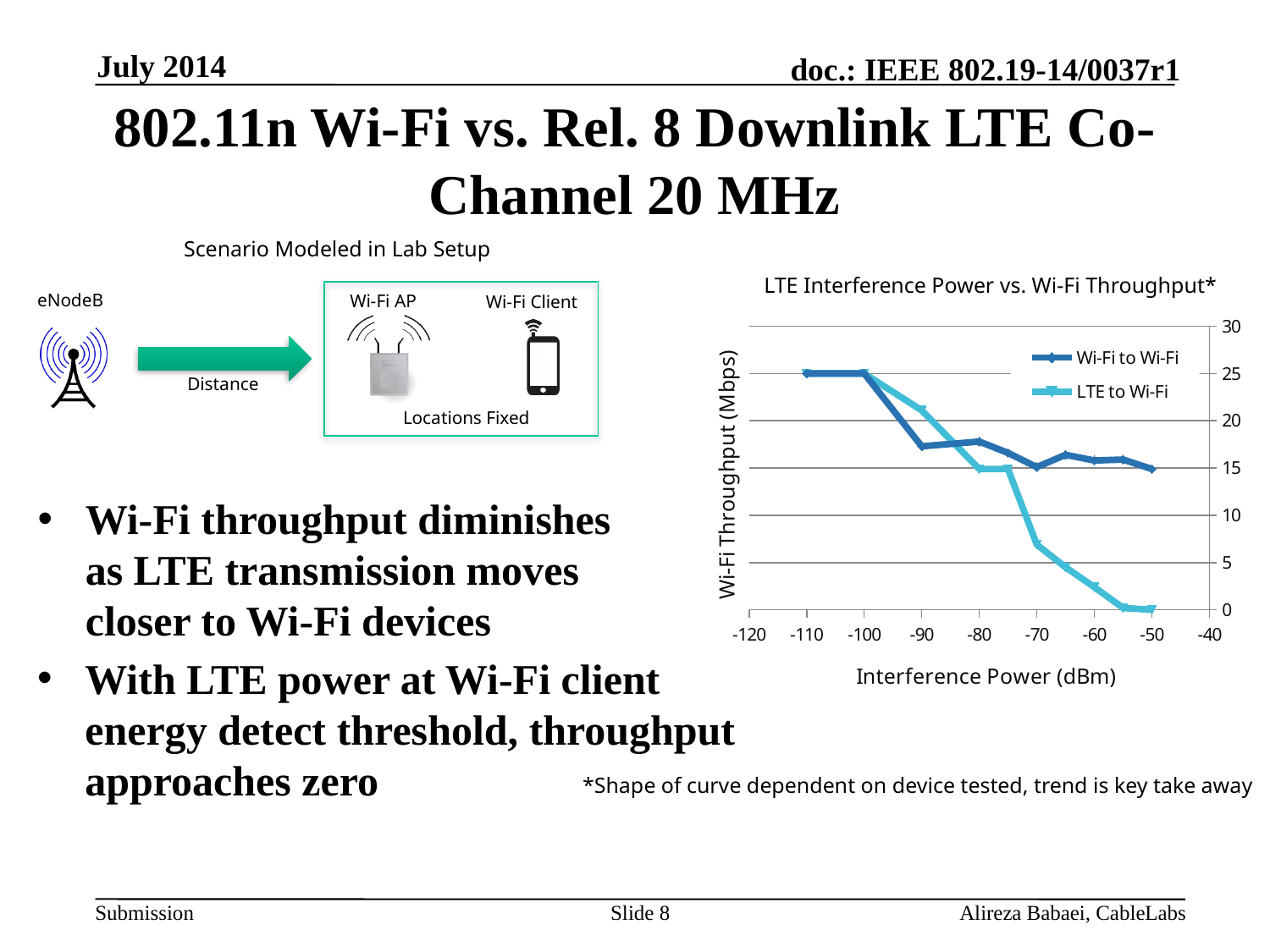
At -60 dBm interference power, which series has the lower Wi-Fi throughput, Wi-Fi to Wi-Fi or LTE to Wi-Fi? LTE to Wi-Fi At -70 dBm interference power, which series has the higher Wi-Fi throughput, Wi-Fi to Wi-Fi or LTE to Wi-Fi? Wi-Fi to Wi-Fi How many series does the chart legend list? 2 Is the Wi-Fi to Wi-Fi throughput at -50 dBm interference power greater or less than 10 Mbps? greater What kind of chart is shown on the slide? line chart What is the label of the chart's x axis? Interference Power (dBm) Does the LTE to Wi-Fi throughput rise or fall as interference power increases from -110 dBm to -50 dBm? fall Is the LTE to Wi-Fi throughput at -70 dBm interference power greater or less than 10 Mbps? less Is the LTE to Wi-Fi throughput at -50 dBm interference power greater or less than 5 Mbps? less What is the title of the chart? LTE Interference Power vs. Wi-Fi Throughput*